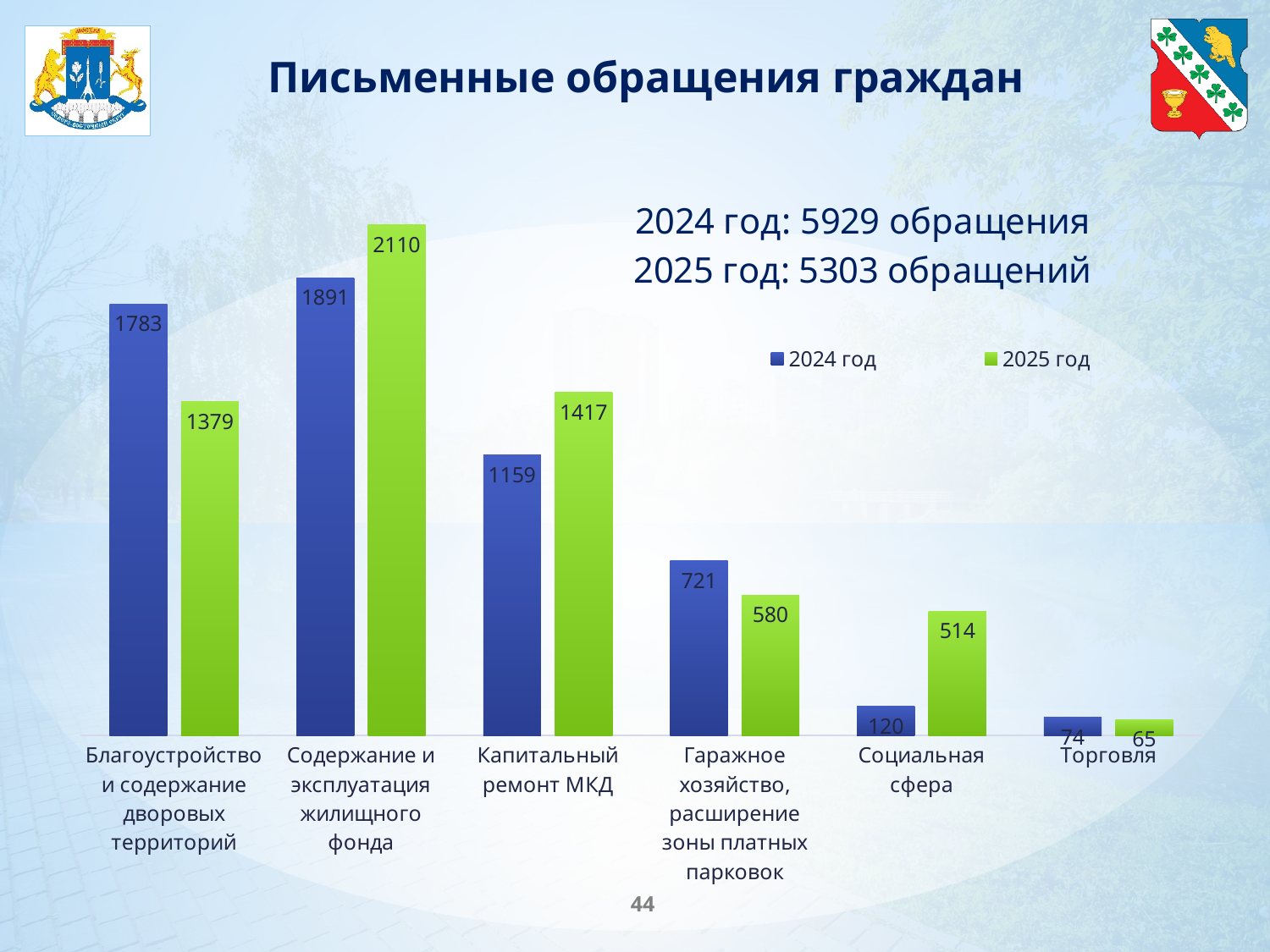
What is the value for 2025 год in the category Социальная сфера? 514 Which category has the lowest value for 2024 год? Торговля How many series does the legend list? 2 Which is larger for Благоустройство и содержание дворовых территорий: the 2024 год value or the 2025 год value? 2024 год What is the difference between the 2025 год and 2024 год values for Содержание и эксплуатация жилищного фонда? 219 What is the value for 2025 год in the category Капитальный ремонт МКД? 1417 What kind of chart is shown on the slide? Bar chart What is the value for 2024 год in the category Благоустройство и содержание дворовых территорий? 1783 What is the title of the slide containing the chart? Письменные обращения граждан What is the difference between the 2024 год and 2025 год values for Гаражное хозяйство, расширение зоны платных парковок? 141 Which category has the highest value for 2025 год? Содержание и эксплуатация жилищного фонда How many categories are shown on the x axis of the chart? 6